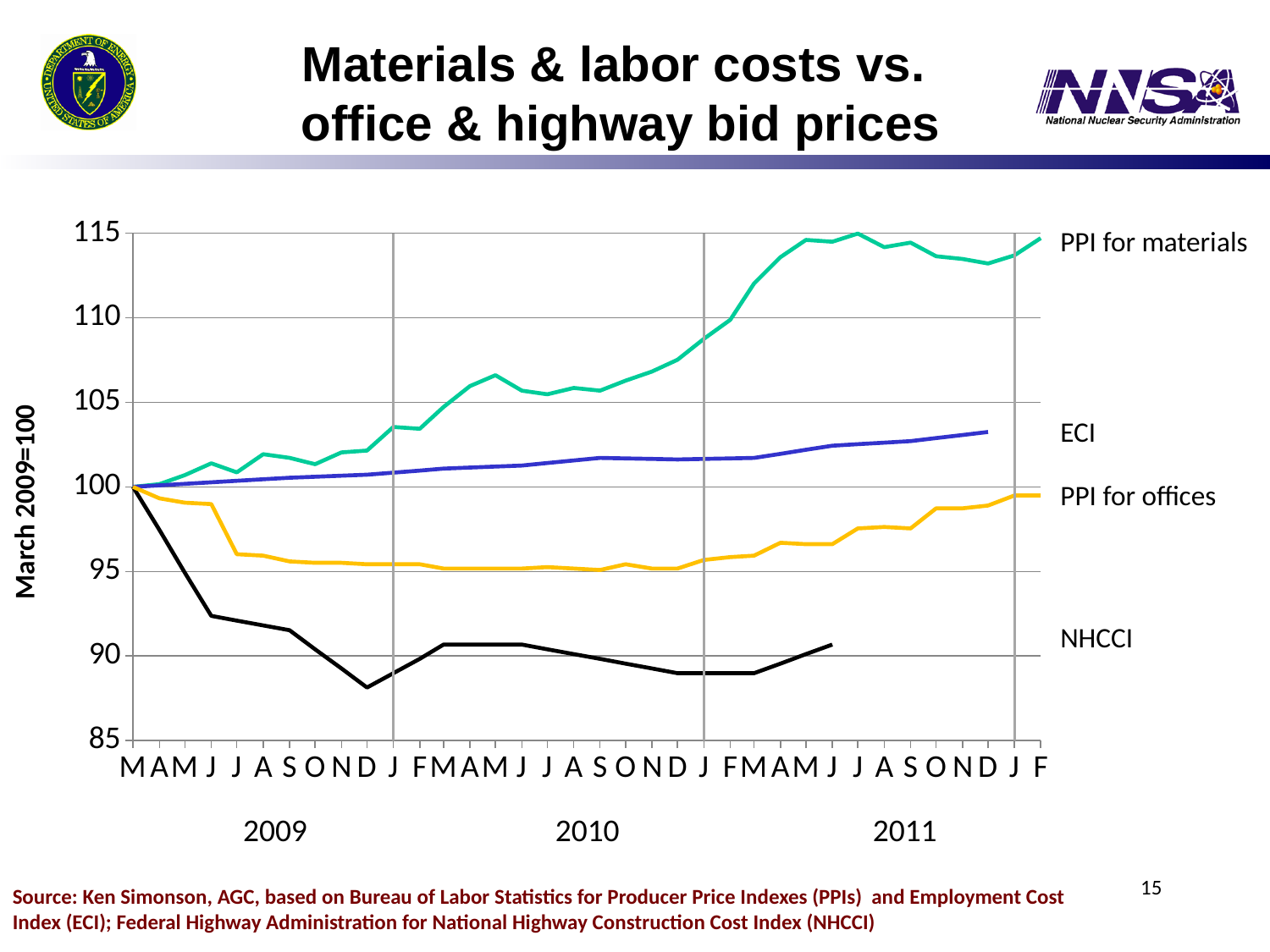
Is the value of NHCCI in December 2009 greater or less than 90? less What is the value of every series in March 2009, the base month of the index? 100 Which series has the highest value in February 2012? PPI for materials In February 2012, which is higher: PPI for materials or ECI? PPI for materials Does the PPI for materials series generally rise or fall from March 2009 to February 2012? rise What is the label on the vertical axis of the chart? March 2009=100 How many data series are plotted on the chart? 4 Is the value of PPI for materials in February 2012 greater or less than 110? greater What kind of chart is shown on the slide? line chart Is the value of PPI for offices in January 2010 greater or less than 100? less Which series stays lowest on the chart throughout the period shown? NHCCI Does the NHCCI series rise or fall from March 2009 to December 2009? fall